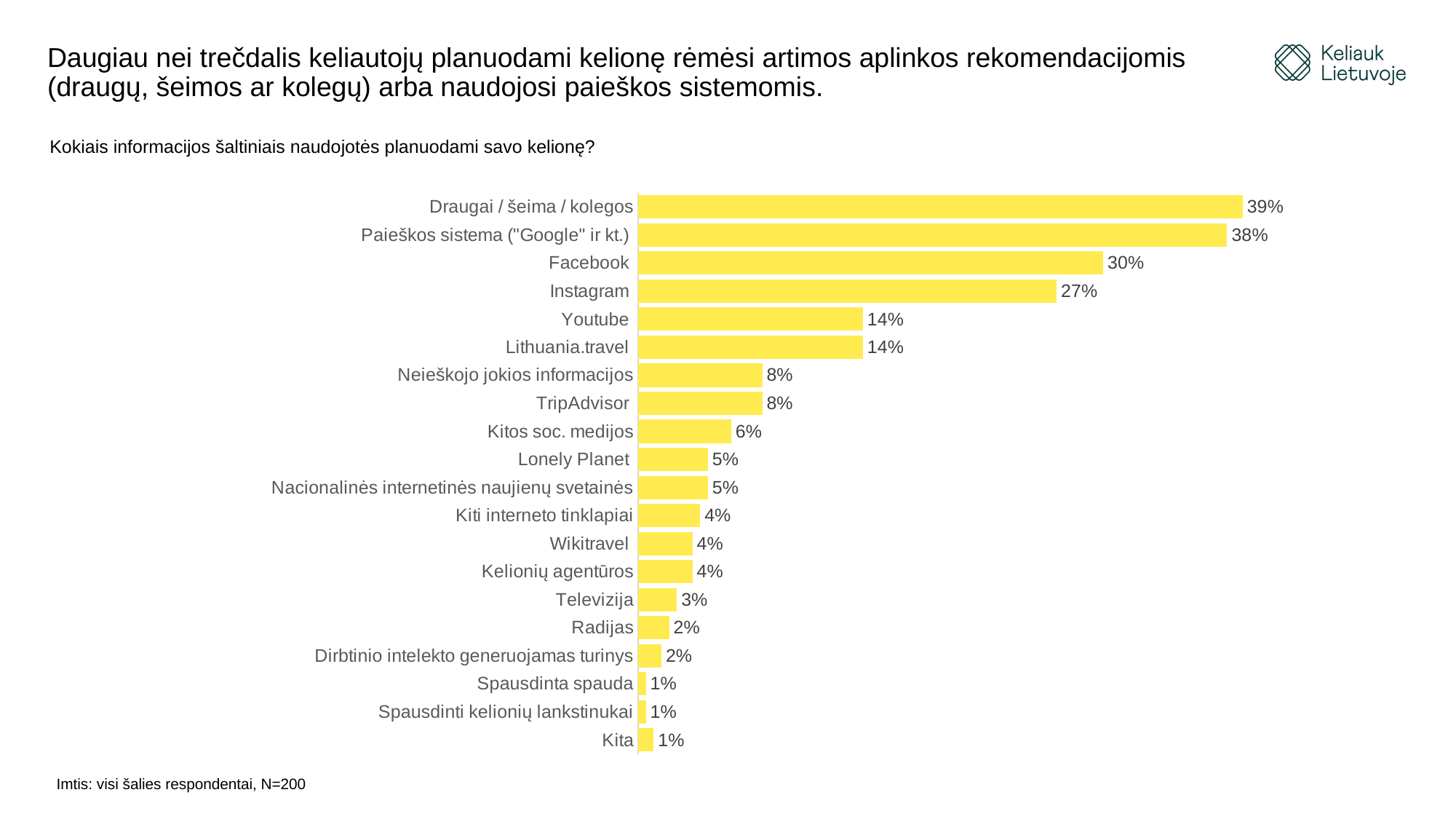
What type of chart is shown on the slide? Bar chart What is the difference between the values for Draugai / šeima / kolegos and Paieškos sistema ("Google" ir kt.)? 1% Which has a larger value, Televizija or Radijas? Televizija What is the sample size stated at the bottom of the slide? N=200 What is the value shown for Instagram? 27% What is the value for TripAdvisor? 8% Which information source has the highest percentage in the chart? Draugai / šeima / kolegos Which has a larger value, Youtube or Kitos soc. medijos? Youtube How many information sources (categories) are shown in the chart? 20 What percentage of respondents used Facebook when planning their trip? 30% What is the difference between the values for Facebook and Instagram? 3% What percentage is shown for Lithuania.travel? 14%